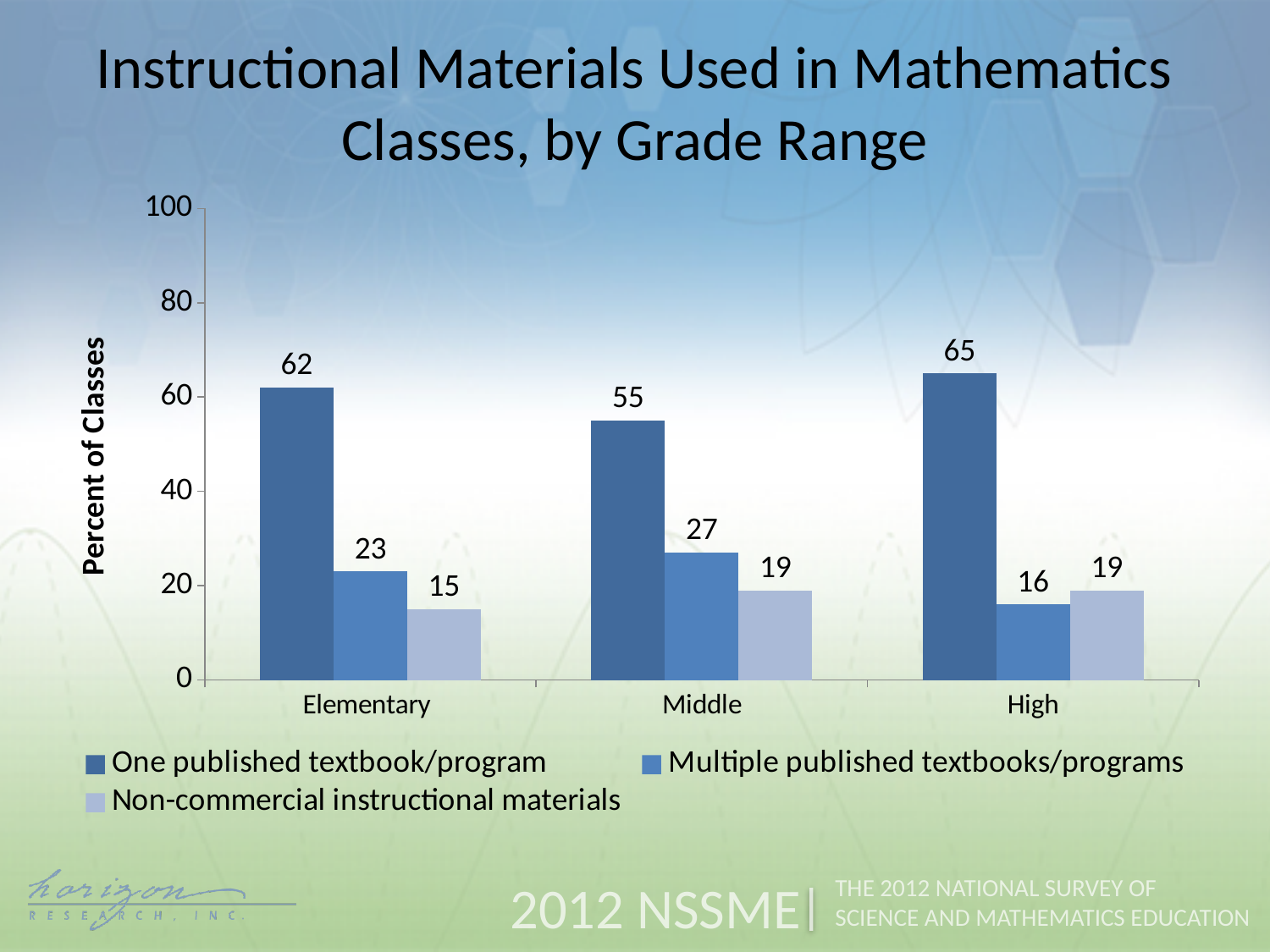
How many series does the legend list? 3 Which is larger: multiple published textbooks/programs for Elementary or for Middle? Middle Which grade range has the lowest value for non-commercial instructional materials? Elementary Is the value for one published textbook/program in Middle greater or less than 60? less What kind of chart is shown on the slide? Bar chart Which grade range has the highest value for one published textbook/program? High What is the label of the y axis? Percent of Classes What is the value for non-commercial instructional materials in middle school classes? 19 What is the difference between the one published textbook/program values for High and Middle? 10 How many grade ranges are shown on the x axis? 3 What percent of elementary classes use one published textbook/program? 62 What is the value for multiple published textbooks/programs in high school classes? 16